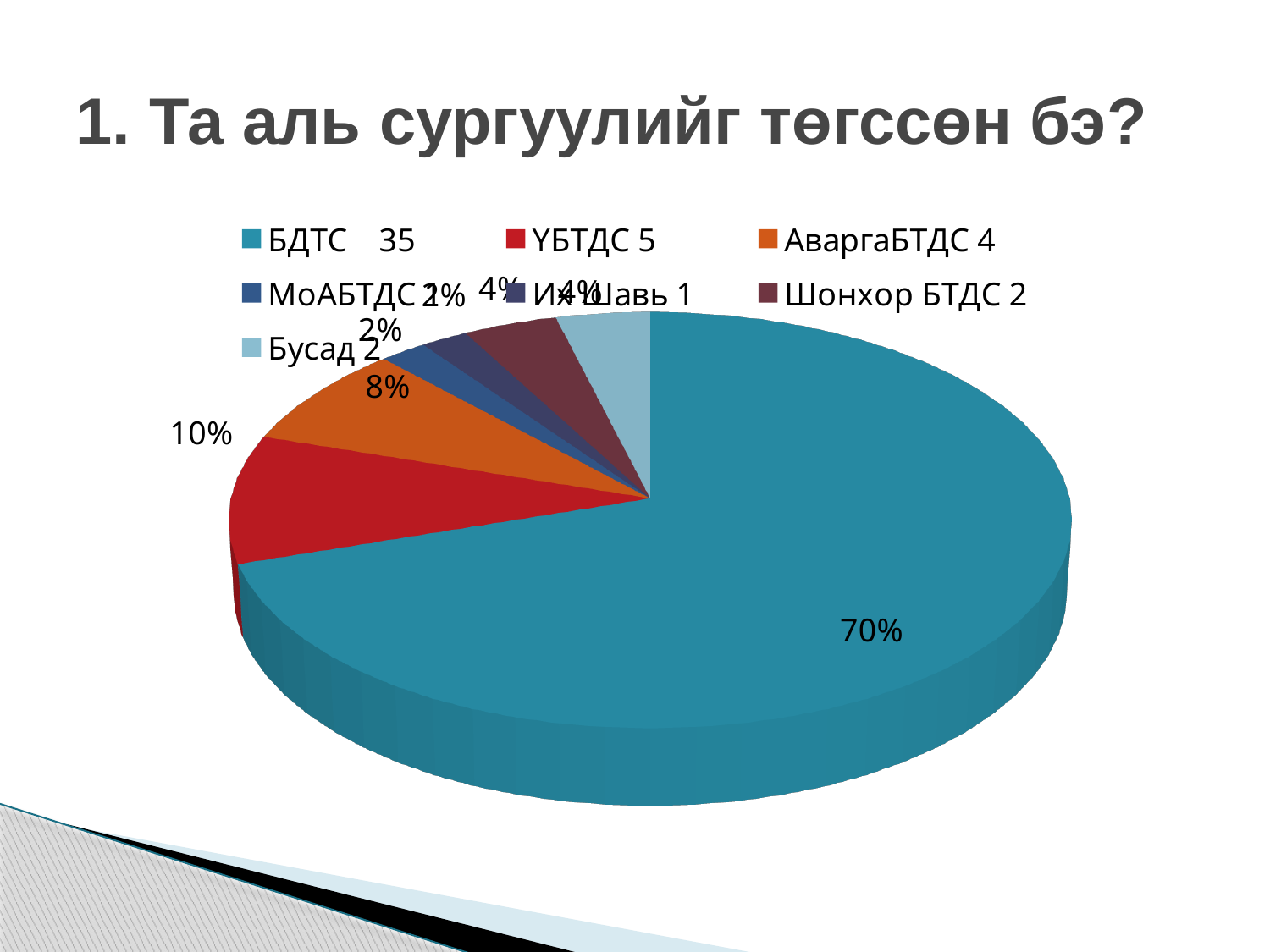
What is the difference in percentage points between the БДТС slice and the ҮБТДС slice? 60% Which slice is larger, ҮБТДС or АваргаБТДС? ҮБТДС Which category has the largest slice of the pie? БДТС How many categories does the pie chart show? 7 What is the difference in percentage points between the ҮБТДС slice and the АваргаБТДС slice? 2% What number is shown next to БДТС in the legend? 35 What share of the pie does АваргаБТДС have? 8% What share of the pie does ҮБТДС have? 10% What kind of chart is shown on the slide? pie chart What is the title of the slide? 1. Та аль сургуулийг төгссөн бэ? What share of the pie does БДТС have? 70%